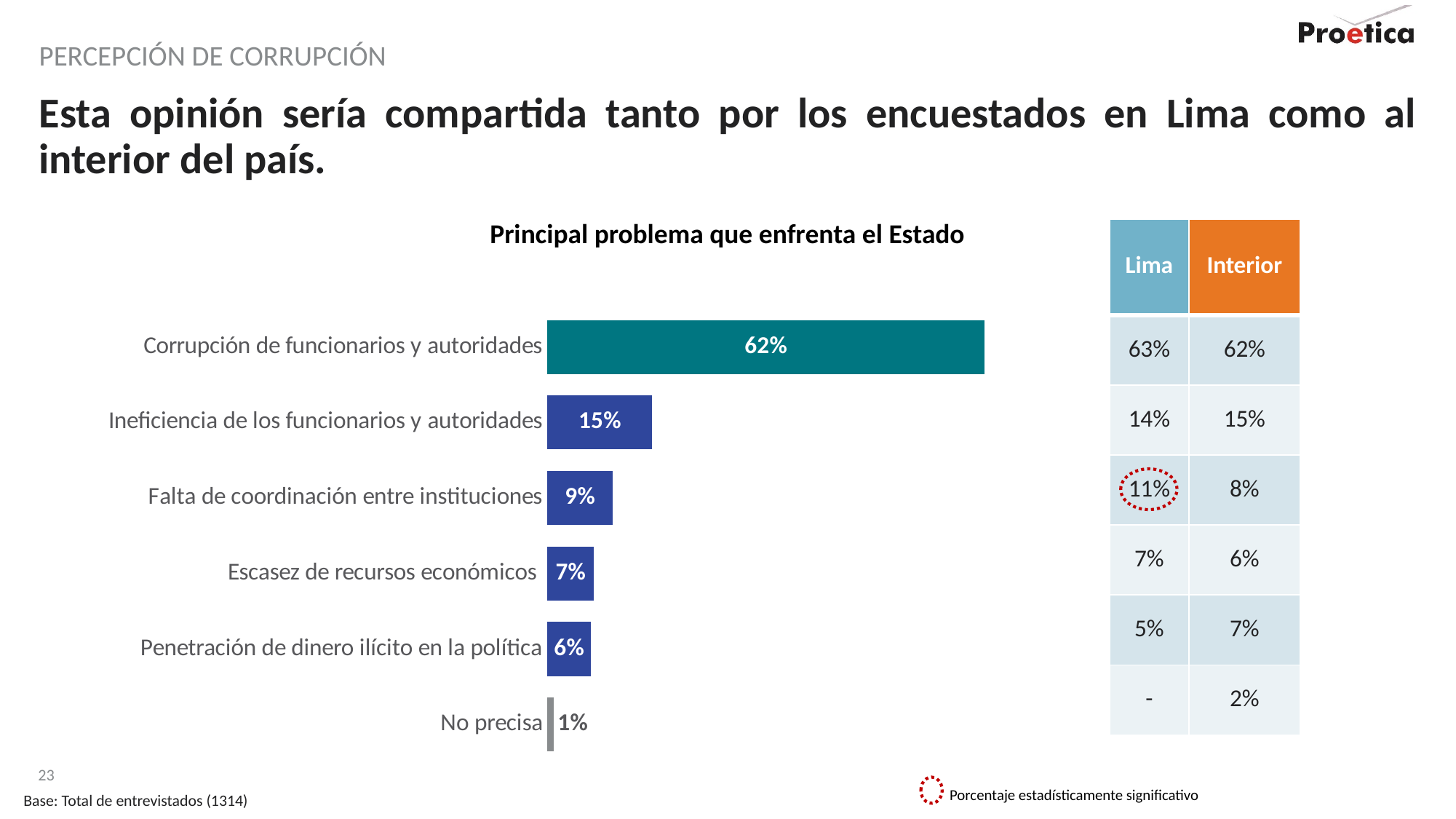
What is the difference between the values for "Falta de coordinación entre instituciones" and "Escasez de recursos económicos"? 2% What is the difference between the values for "Corrupción de funcionarios y autoridades" and "Ineficiencia de los funcionarios y autoridades"? 47% Which category has the lowest value in the chart? No precisa Which category has the highest value in the chart? Corrupción de funcionarios y autoridades What is the value for "Corrupción de funcionarios y autoridades" in the chart? 62% How many categories are shown in the chart? 6 What kind of chart is shown on the slide? Bar chart What is the value for "Ineficiencia de los funcionarios y autoridades"? 15% What is the value for "Penetración de dinero ilícito en la política"? 6% What is the value for "Falta de coordinación entre instituciones"? 9% What is the title of the chart? Principal problema que enfrenta el Estado Which is larger: the value for "Escasez de recursos económicos" or for "Penetración de dinero ilícito en la política"? Escasez de recursos económicos